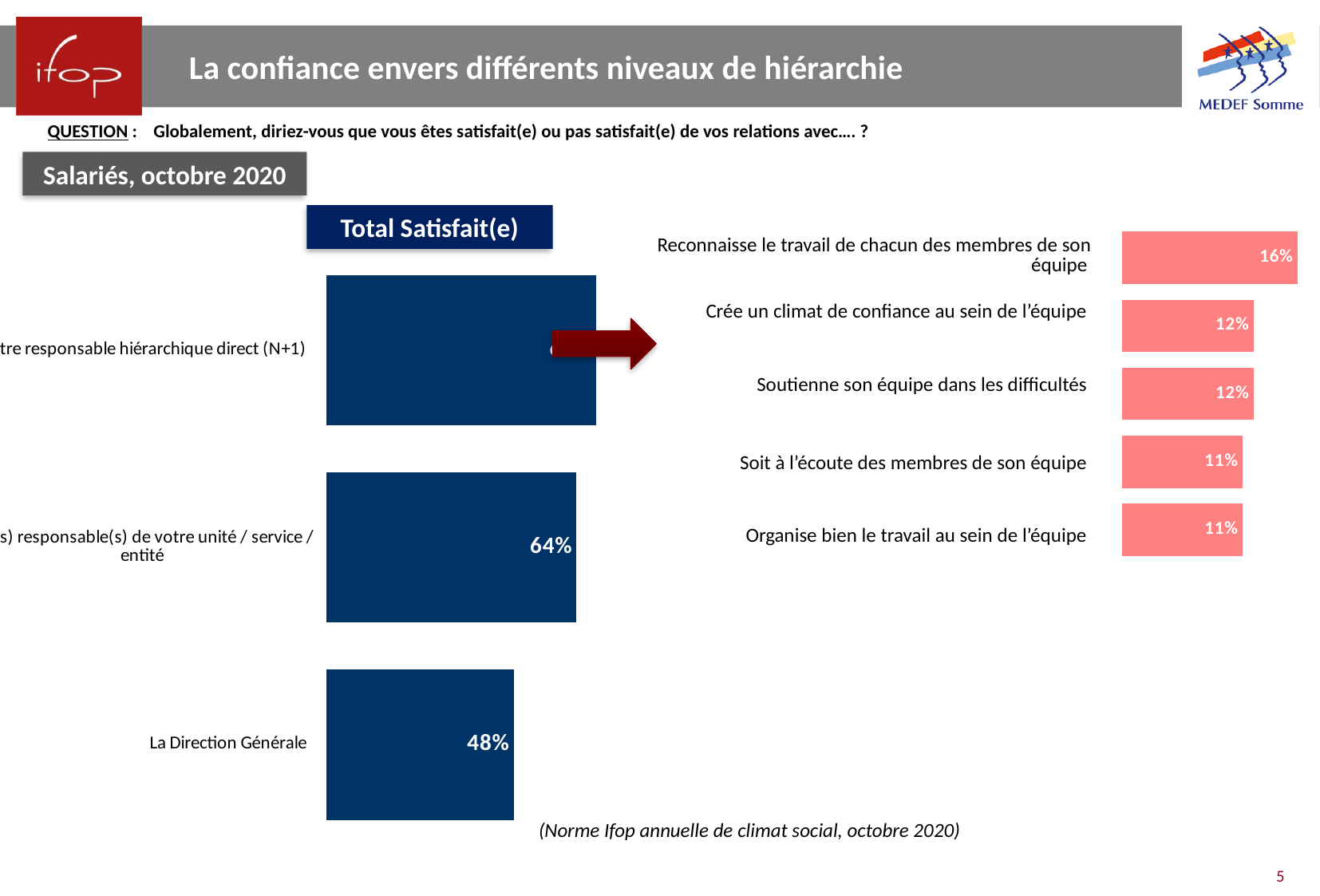
In the 'Total Satisfait(e)' chart on the left, what is the value for 'La Direction Générale'? 48% In the 'Total Satisfait(e)' chart on the left, which category has the longest bar? Votre responsable hiérarchique direct (N+1) In the chart on the right, what is the value for 'Soutienne son équipe dans les difficultés'? 12% In the 'Total Satisfait(e)' chart on the left, which category has the lowest value? La Direction Générale In the chart on the right, what is the value for 'Reconnaisse le travail de chacun des membres de son équipe'? 16% In the chart on the right, how many items are shown? 5 What kind of chart is the 'Total Satisfait(e)' chart on the left? Bar chart In the 'Total Satisfait(e)' chart on the left, what is the value for the responsable(s) de votre unité / service / entité? 64% In the 'Total Satisfait(e)' chart on the left, how many categories are shown? 3 In the chart on the right, what is the difference between the value for 'Reconnaisse le travail de chacun des membres de son équipe' and the value for 'Organise bien le travail au sein de l'équipe'? 5 percentage points In the chart on the right, which item has the highest value? Reconnaisse le travail de chacun des membres de son équipe In the 'Total Satisfait(e)' chart on the left, what is the difference between the value for the responsable(s) de votre unité / service / entité and the value for La Direction Générale? 16 percentage points